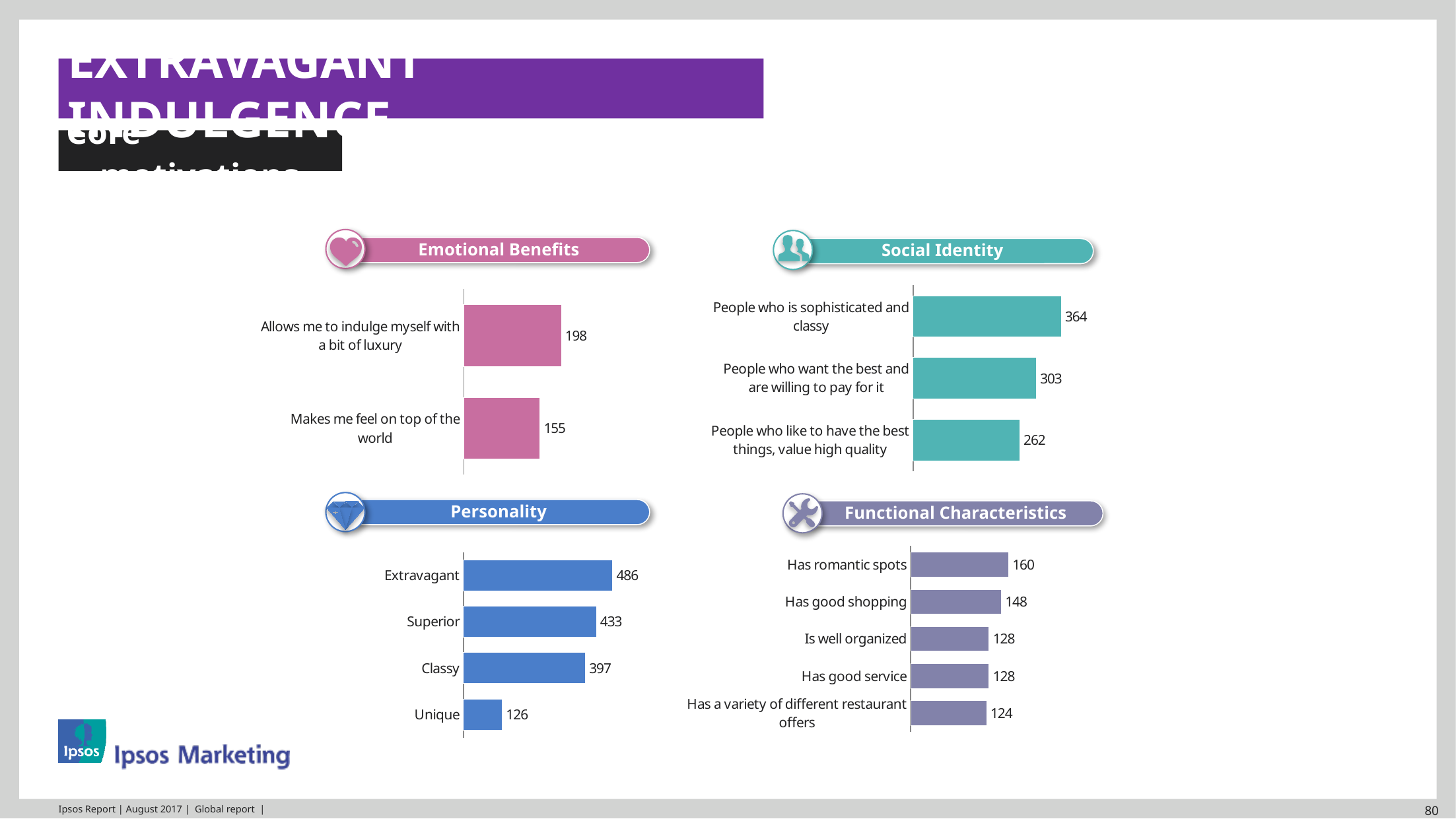
In the Personality chart, what is the difference between Extravagant and Classy? 89 In the Functional Characteristics chart, which is larger: "Has romantic spots" or "Has a variety of different restaurant offers"? Has romantic spots In the Personality chart, what is the value for Superior? 433 In the Emotional Benefits chart, what is the value for "Allows me to indulge myself with a bit of luxury"? 198 In the Emotional Benefits chart, what is the difference between the two bars? 43 In the Personality chart, which category has the lowest value? Unique In the Functional Characteristics chart, how many categories are shown? 5 What kind of chart is the Personality chart? Bar chart In the Functional Characteristics chart, what is the value for "Has good shopping"? 148 In the Social Identity chart, what is the value for "People who like to have the best things, value high quality"? 262 In the Social Identity chart, which category has the highest value? People who is sophisticated and classy In the Social Identity chart, how many categories are shown? 3